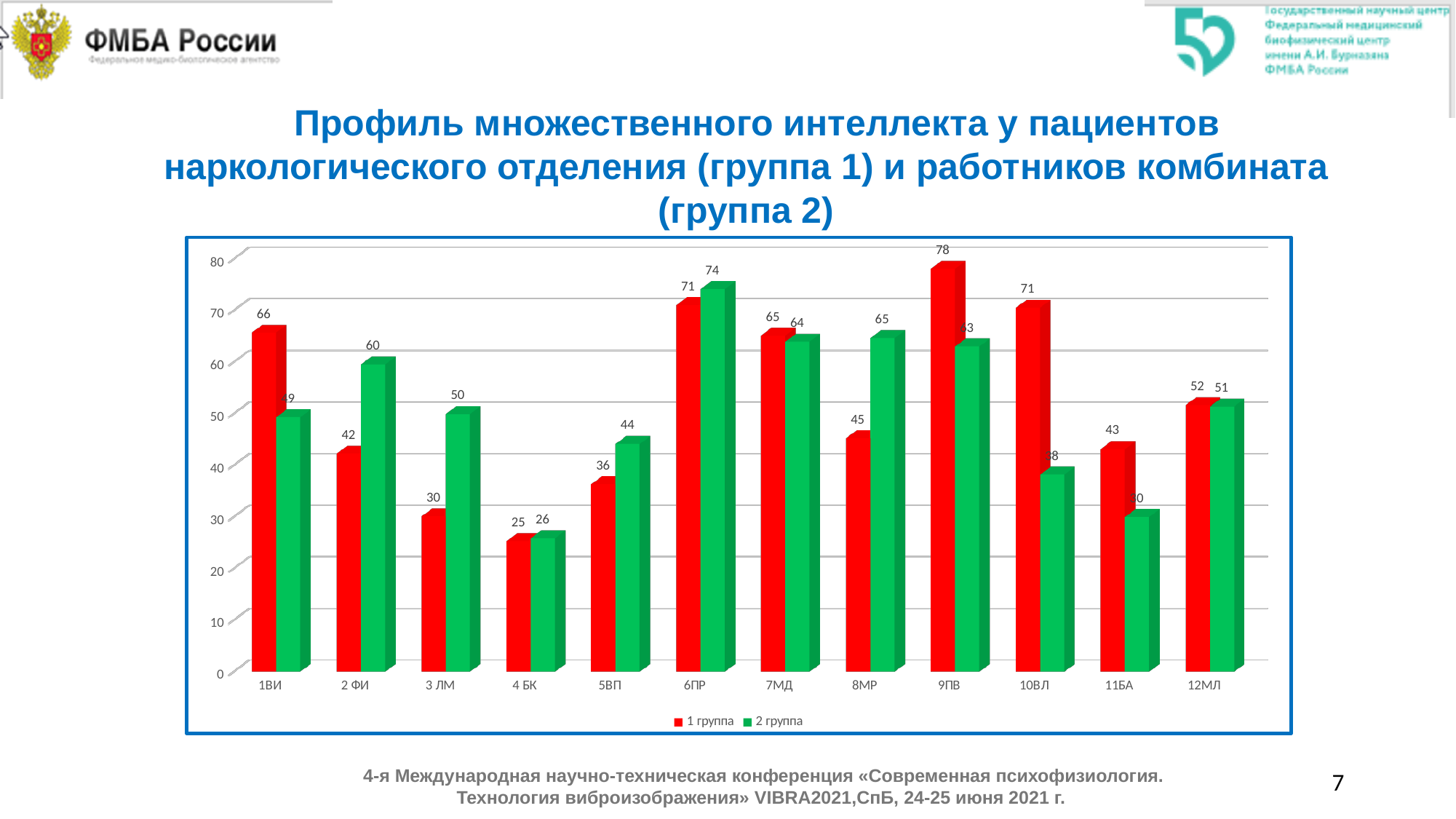
What is the difference between the 2 группа and 1 группа values at 3 ЛМ? 20 Which is larger at 8МР: the value for 1 группа or for 2 группа? 2 группа Which colour represents 1 группа in the chart? red How many categories are shown on the x axis? 12 What is the value for 2 группа at 2 ФИ? 60 What is the value for 1 группа at 8МР? 45 What is the value for 1 группа at 9ПВ? 78 Is the value for 2 группа at 1ВИ greater or less than 60? less Which category has the highest value for 1 группа? 9ПВ What kind of chart is shown on the slide? bar chart Which category has the lowest value for 2 группа? 4 БК How many series does the legend list? 2